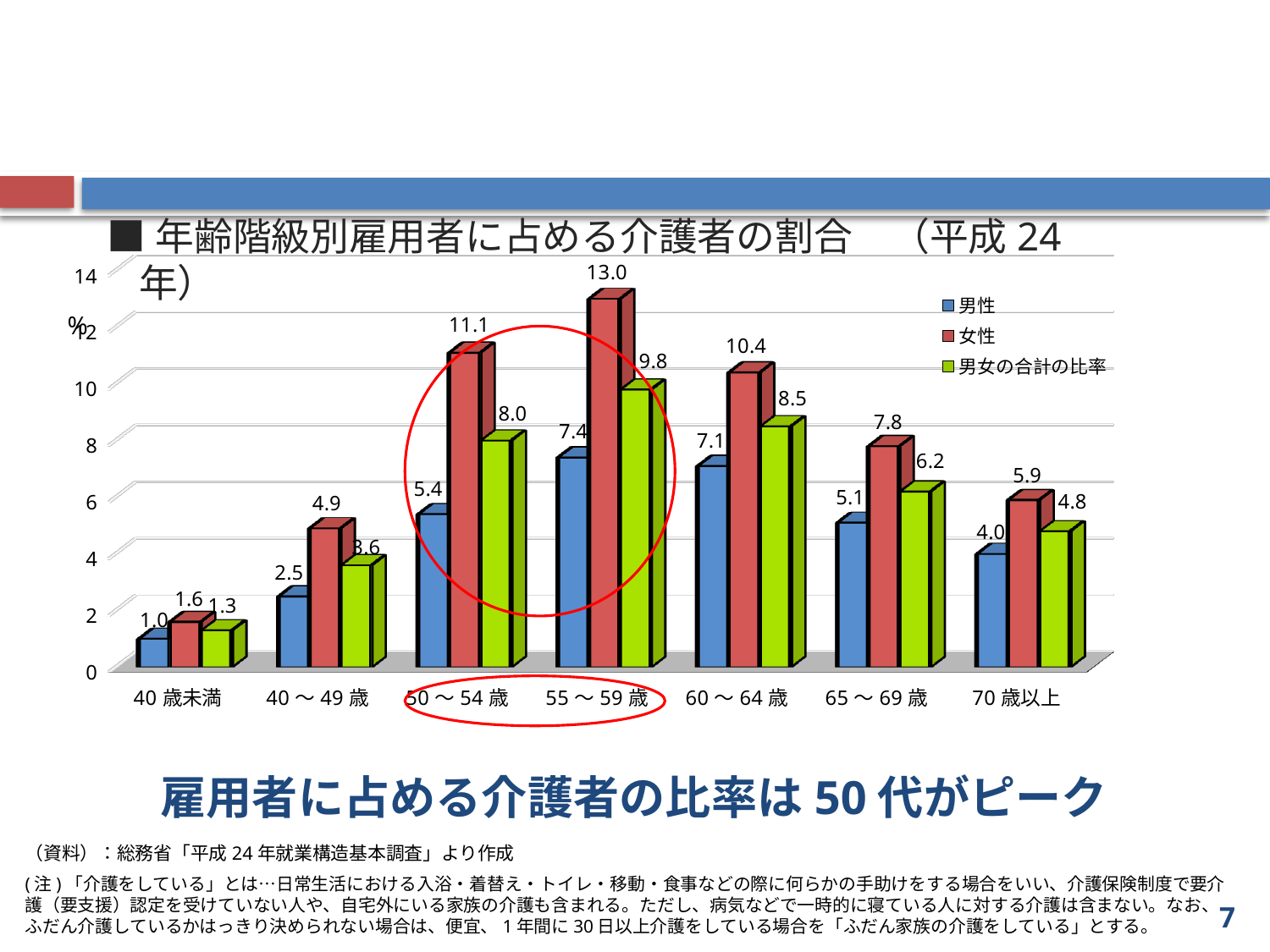
What is the value for 男性 in the 50～54歳 category? 5.4 What is the value for 女性 in the 55～59歳 category? 13.0 Do the 女性 values rise or fall from 55～59歳 to 70歳以上? fall Which series is shown in green in the legend? 男女の合計の比率 Which is larger: the 男性 value for 55～59歳 or the 男性 value for 60～64歳? 55～59歳 Which age category has the lowest value for 男性? 40歳未満 Which age category has the highest value for 女性? 55～59歳 What kind of chart is shown on the slide? bar chart How many series does the legend list? 3 How many age categories are shown on the x axis? 7 What is the value for 男女の合計の比率 in the 60～64歳 category? 8.5 What is the difference between the 女性 and 男性 values in the 50～54歳 category? 5.7